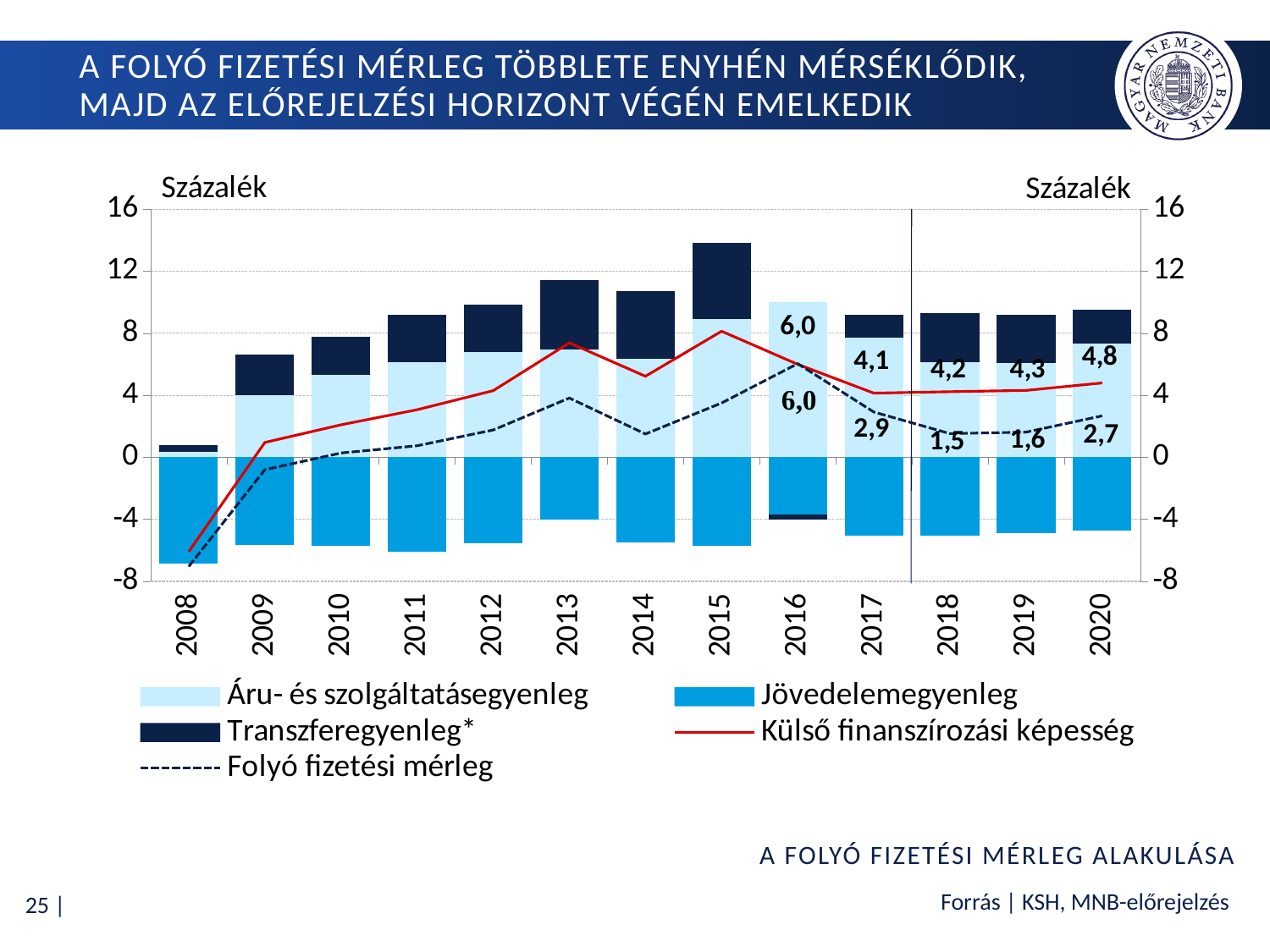
Does Folyó fizetési mérleg rise or fall from 2018 to 2020? rise What is the value of Külső finanszírozási képesség in 2020? 4,8 What is the difference between Külső finanszírozási képesség and Folyó fizetési mérleg in 2020? 2,1 How many series does the legend list? 5 How many years are shown on the x axis? 13 Among the labelled years (2016–2020), in which year is Folyó fizetési mérleg lowest? 2018 What is the value of Folyó fizetési mérleg in 2018? 1,5 By how much did Folyó fizetési mérleg fall from 2016 to 2017? 3,1 In 2017, which is larger: Külső finanszírozási képesség or Folyó fizetési mérleg? Külső finanszírozási képesség Is the Jövedelemegyenleg value for 2008 greater or less than -4? less Among the labelled years (2016–2020), in which year is Folyó fizetési mérleg highest? 2016 What is the value of Külső finanszírozási képesség in 2019? 4,3